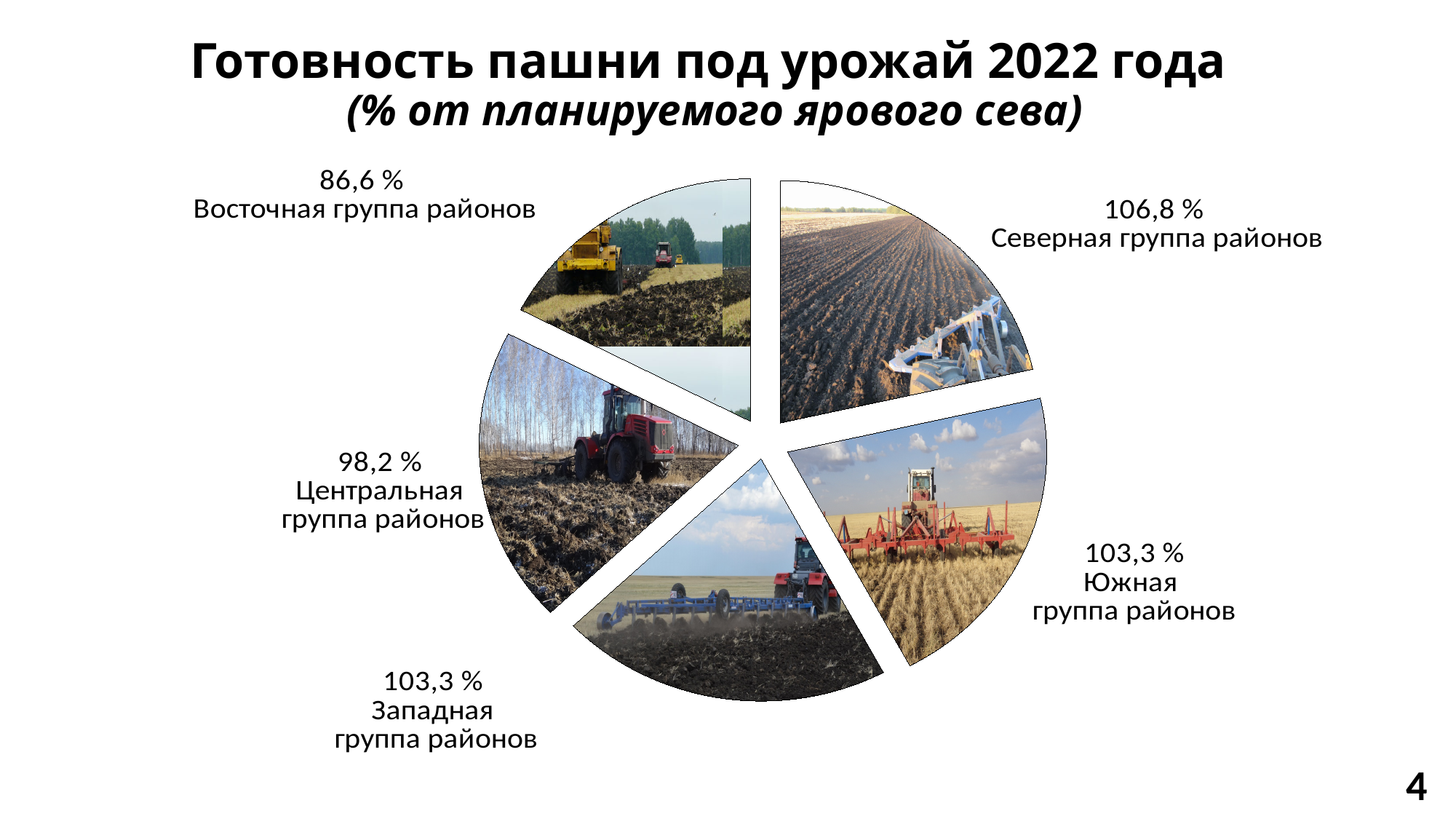
What is the value for Западная группа районов? 103,3 % What is the value for Северная группа районов? 106,8 % What is the value for Восточная группа районов? 86,6 % Which group of districts has the highest value? Северная группа районов What is the title of the chart? Готовность пашни под урожай 2022 года (% от планируемого ярового сева) Which is larger, the value for Северная группа районов or Центральная группа районов? Северная группа районов What is the value for Центральная группа районов? 98,2 % What is the difference between the values for Центральная группа районов and Восточная группа районов? 11,6 % What is the difference between the values for Северная группа районов and Восточная группа районов? 20,2 % Which group of districts has the lowest value? Восточная группа районов What kind of chart is shown on the slide? Pie chart How many groups of districts are shown in the chart? 5